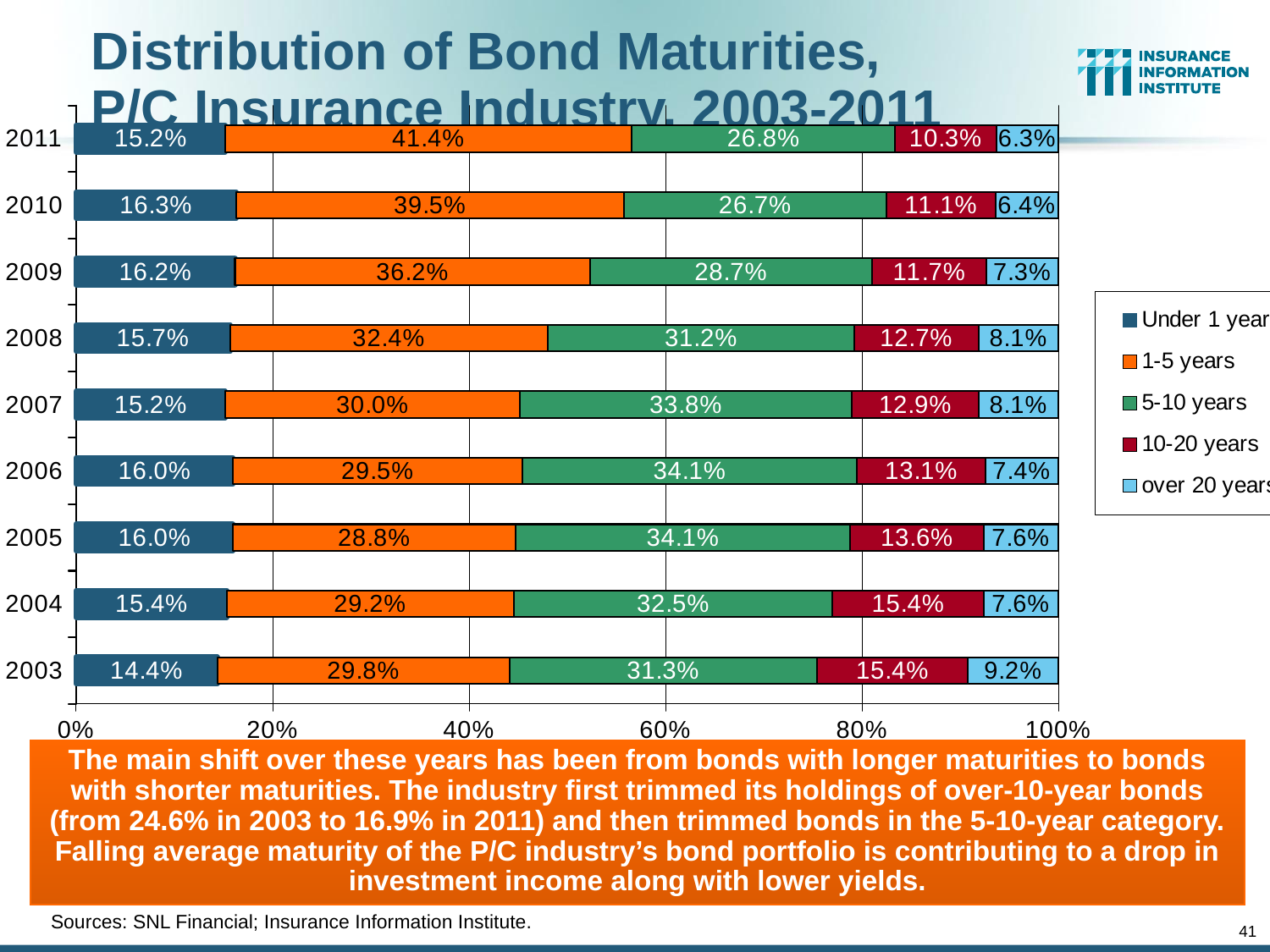
How many years are shown on the chart? 9 In which year was the 1-5 years share the highest? 2011 What type of chart is shown on the slide? Stacked bar chart What was the 5-10 years share in 2007? 33.8% What was the 'over 20 years' share in 2003? 9.2% What share of bonds had maturities of 1-5 years in 2011? 41.4% In which year was the 'over 20 years' share the lowest? 2011 What was the 'Under 1 year' share in 2010? 16.3% Which was larger in 2008: the 1-5 years share or the 5-10 years share? 1-5 years How many maturity categories does the legend list? 5 Did the 10-20 years share rise or fall from 2003 to 2011? Fall By how many percentage points did the 1-5 years share in 2011 exceed the 1-5 years share in 2003? 11.6 percentage points